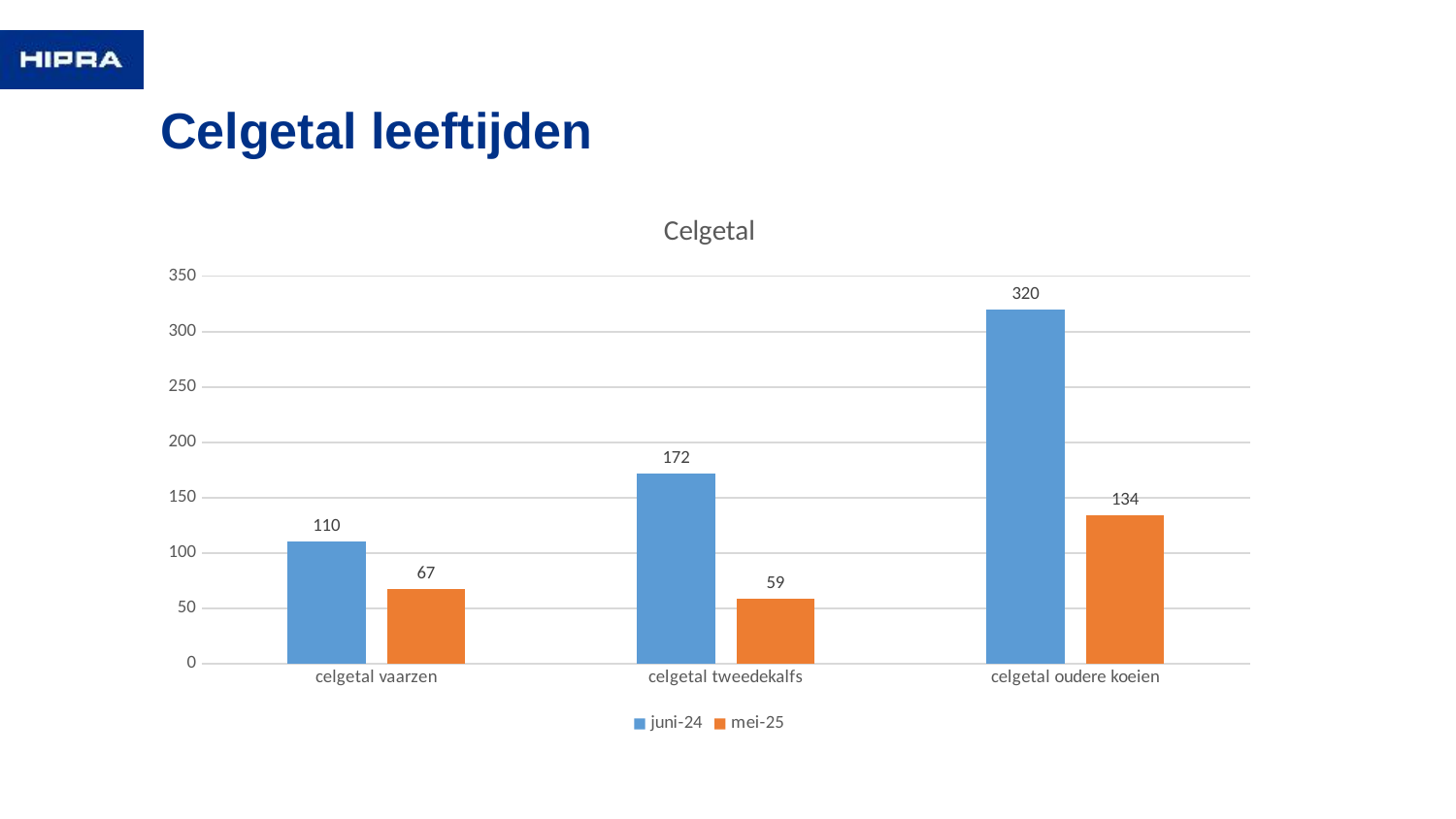
Which category has the highest juni-24 value? celgetal oudere koeien What is the mei-25 value for celgetal oudere koeien? 134 What is the difference between the juni-24 and mei-25 values for celgetal oudere koeien? 186 What is the difference between the juni-24 values for celgetal tweedekalfs and celgetal vaarzen? 62 Which is larger: the mei-25 value for celgetal vaarzen or the mei-25 value for celgetal tweedekalfs? celgetal vaarzen Is the juni-24 value for celgetal oudere koeien greater or less than 300? greater What is the mei-25 value for celgetal tweedekalfs? 59 How many categories are shown on the x axis? 3 Which category has the lowest mei-25 value? celgetal tweedekalfs What kind of chart is shown on the slide? bar chart What is the juni-24 value for celgetal vaarzen? 110 How many series does the legend list? 2